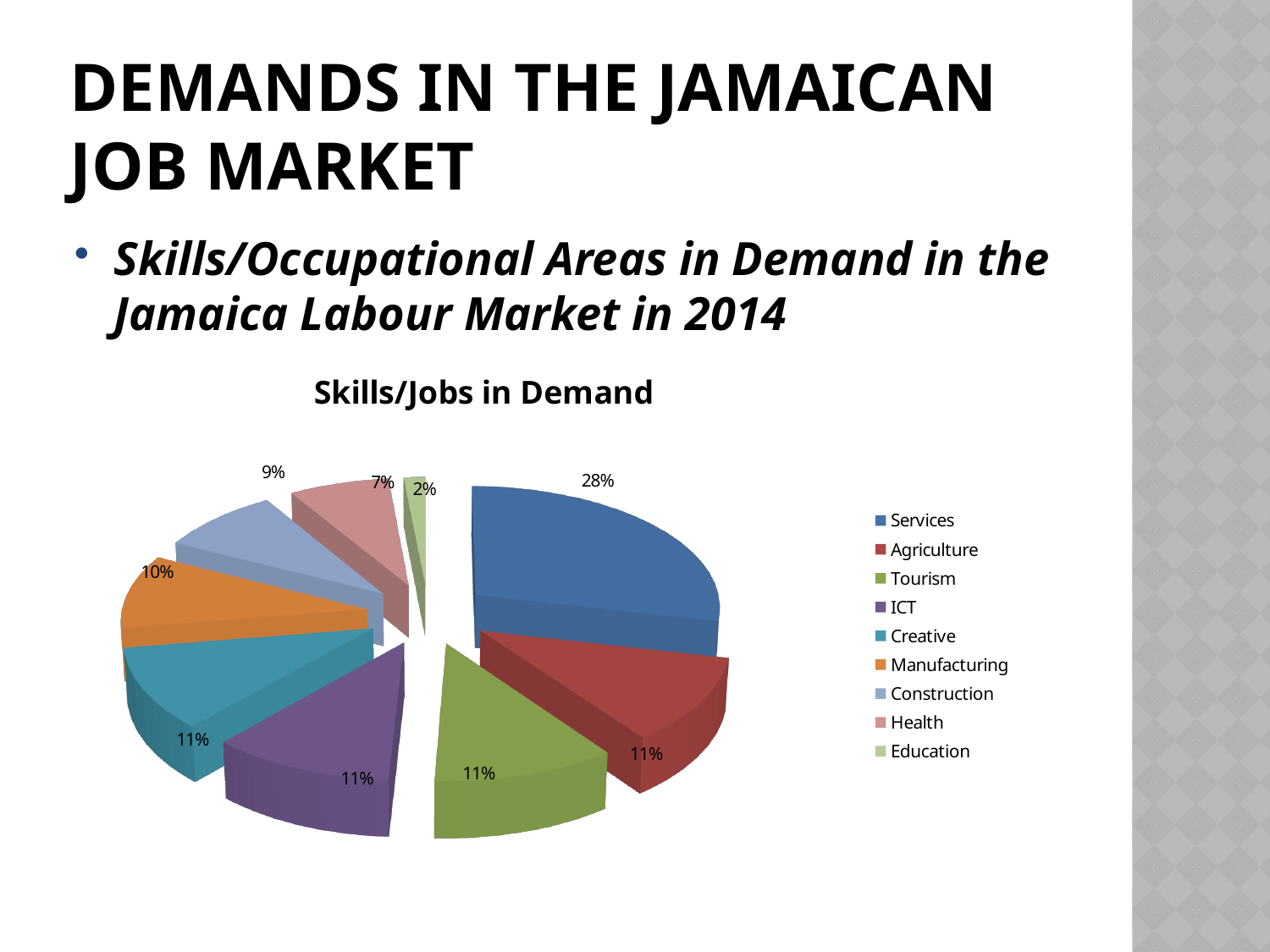
What is the difference in percentage points between Services and Health? 21 What share of the pie does Construction have? 9% What share of the pie does Education have? 2% Which category has the smallest share of the pie? Education What share of the pie does Manufacturing have? 10% Which category has the largest share of the pie? Services Which is larger, the share for Manufacturing or the share for Construction? Manufacturing What is the title of the chart? Skills/Jobs in Demand What share of the pie does Services have? 28% What share of the pie does Health have? 7% How many categories does the pie chart show? 9 What type of chart is shown on the slide? Pie chart